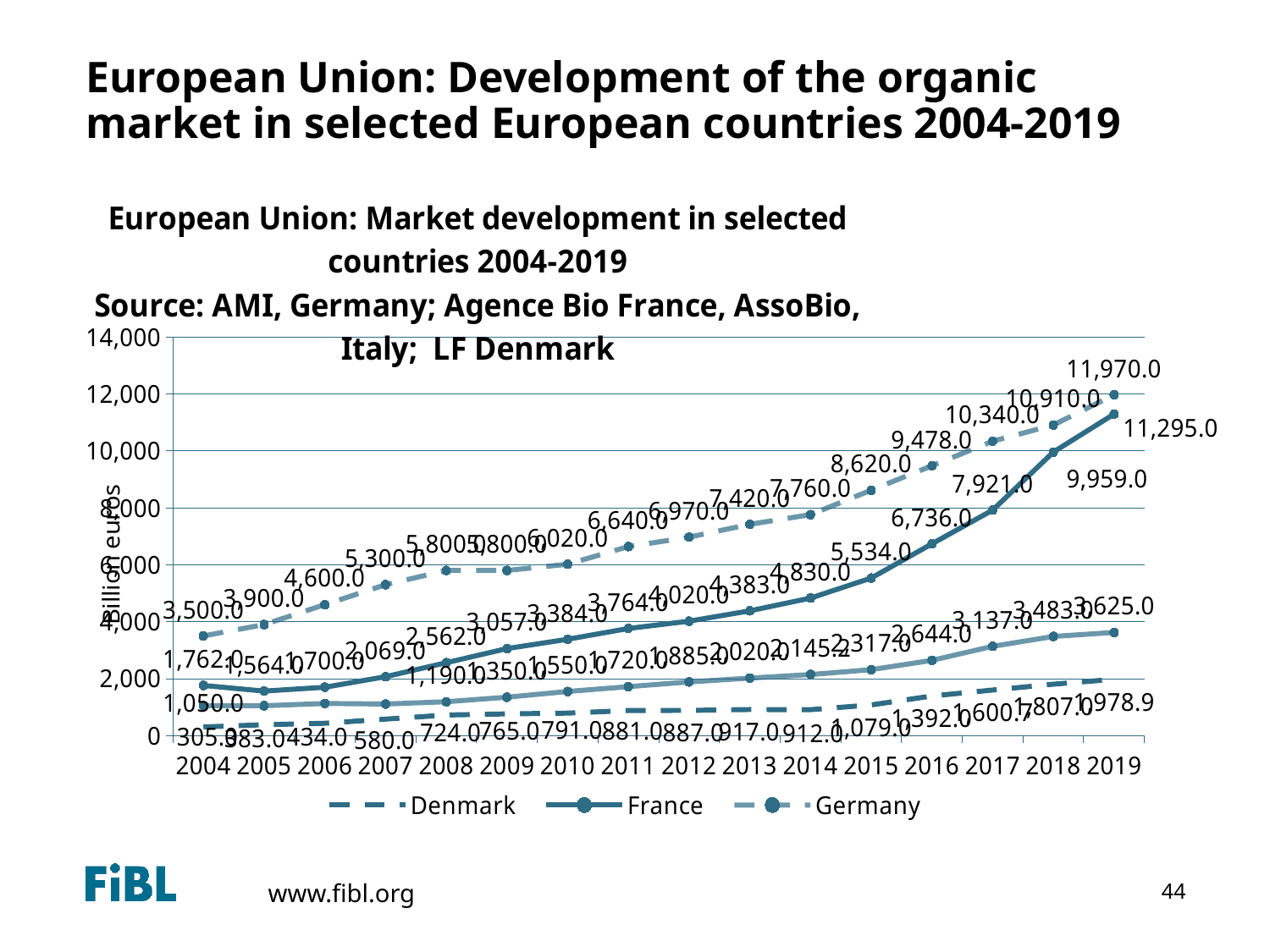
How many series does the chart legend list? 3 What is the label on the y axis of the chart? Million euros What is the difference between the Germany and France values in 2019? 675.0 Is the value for Germany in 2016 greater or less than 10,000? less What type of chart is shown on the slide? line chart Which series has the larger value in 2019, Germany or France? Germany What is the value for Denmark in 2019? 1,978.9 How many years are shown on the x axis of the chart? 16 What is the value for France in 2019? 11,295.0 What is the value for France in 2017? 7,921.0 In which year does the Germany series reach its highest value? 2019 What is the value for Germany in 2019? 11,970.0